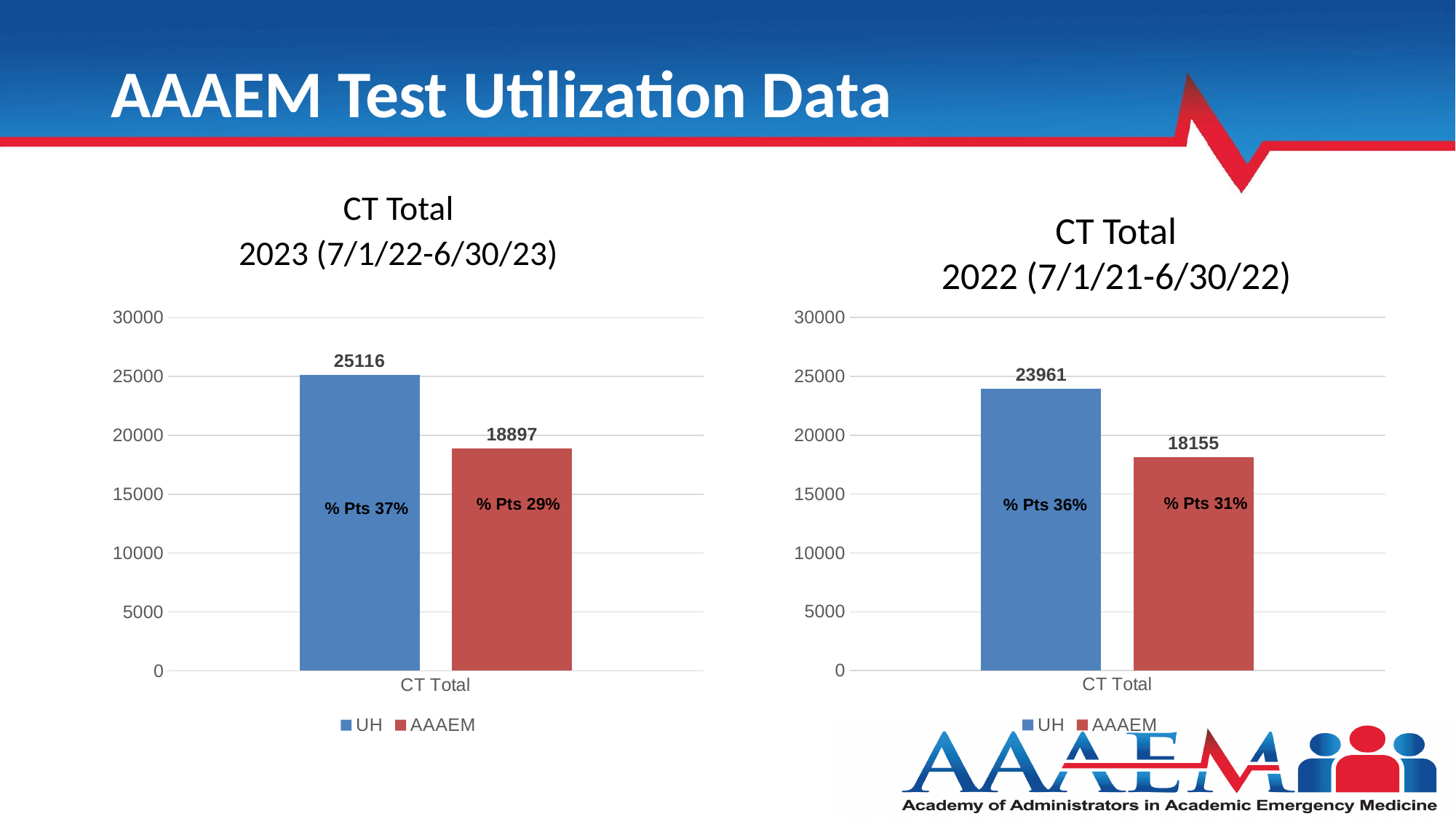
In the CT Total 2023 (7/1/22-6/30/23) chart, what is the difference between the UH and AAAEM values? 6219 In the CT Total 2022 (7/1/21-6/30/22) chart, which series has the lowest value? AAAEM In the CT Total 2023 (7/1/22-6/30/23) chart, which series has the higher value, UH or AAAEM? UH In the CT Total 2022 (7/1/21-6/30/22) chart, what is the value for AAAEM? 18155 In the CT Total 2022 (7/1/21-6/30/22) chart, what is the difference between the UH and AAAEM values? 5806 In the CT Total 2022 (7/1/21-6/30/22) chart, what is the value for UH? 23961 What kind of chart is the CT Total 2023 (7/1/22-6/30/23) chart? bar chart In the CT Total 2023 (7/1/22-6/30/23) chart, is the value for AAAEM greater or less than 20000? less In the CT Total 2023 (7/1/22-6/30/23) chart, what is the value for UH? 25116 How many series does the legend of the CT Total 2022 (7/1/21-6/30/22) chart list? 2 In the CT Total 2023 (7/1/22-6/30/23) chart, what is the value for AAAEM? 18897 In the CT Total 2022 (7/1/21-6/30/22) chart, what % Pts label is shown on the UH bar? % Pts 36%